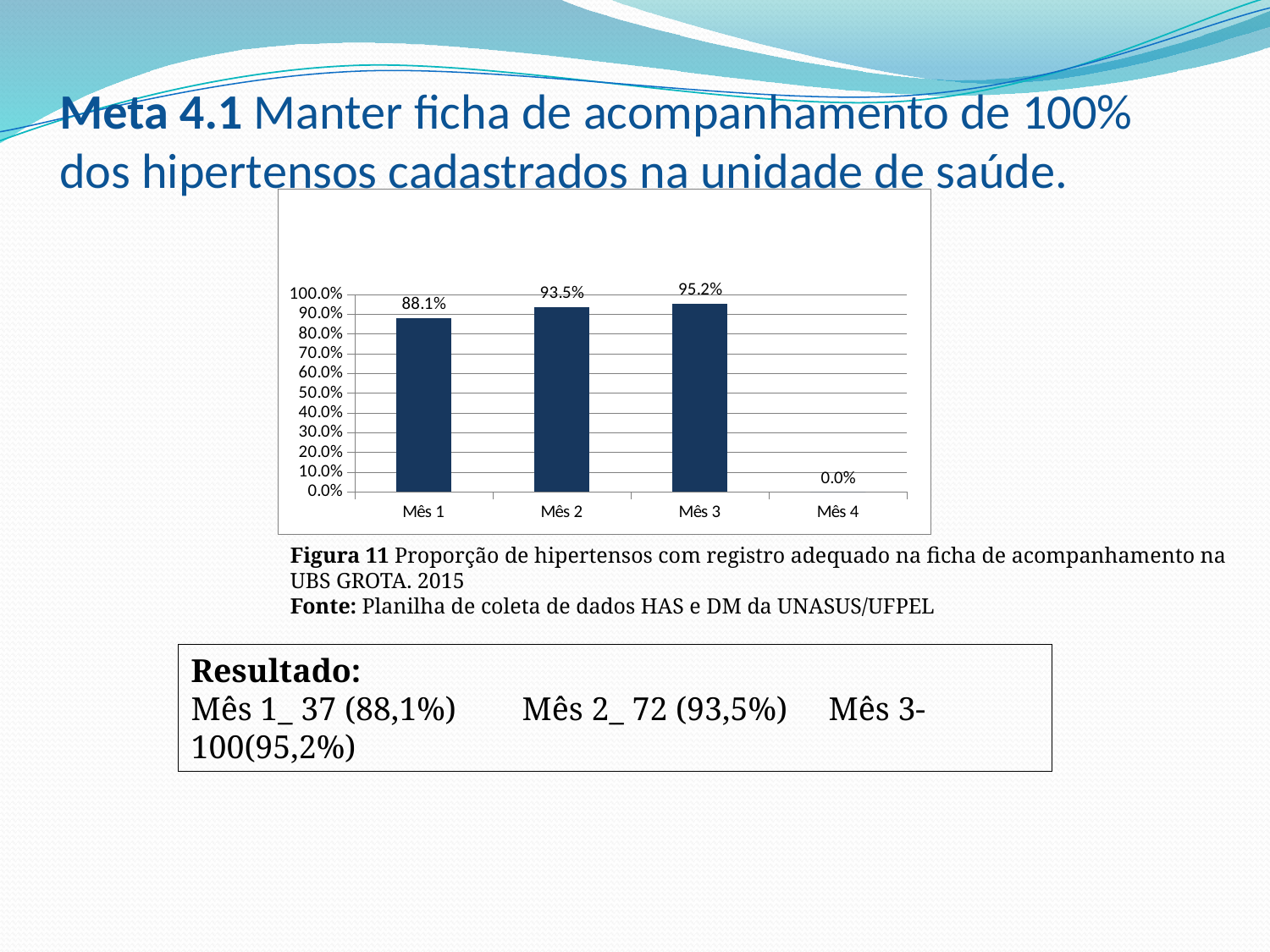
Which month has the lowest value? Mês 4 How many months are shown on the x axis? 4 What is the value for Mês 2? 93.5% What is the value for Mês 3? 95.2% Is the value for Mês 1 greater or less than 90.0%? less What kind of chart is shown on the slide? bar chart What is the value for Mês 1? 88.1% Do the values rise or fall from Mês 1 to Mês 3? rise Which month has the highest value? Mês 3 Which is larger, the value for Mês 2 or the value for Mês 1? Mês 2 What is the value for Mês 4? 0.0% What is the difference between the values for Mês 3 and Mês 1? 7.1%